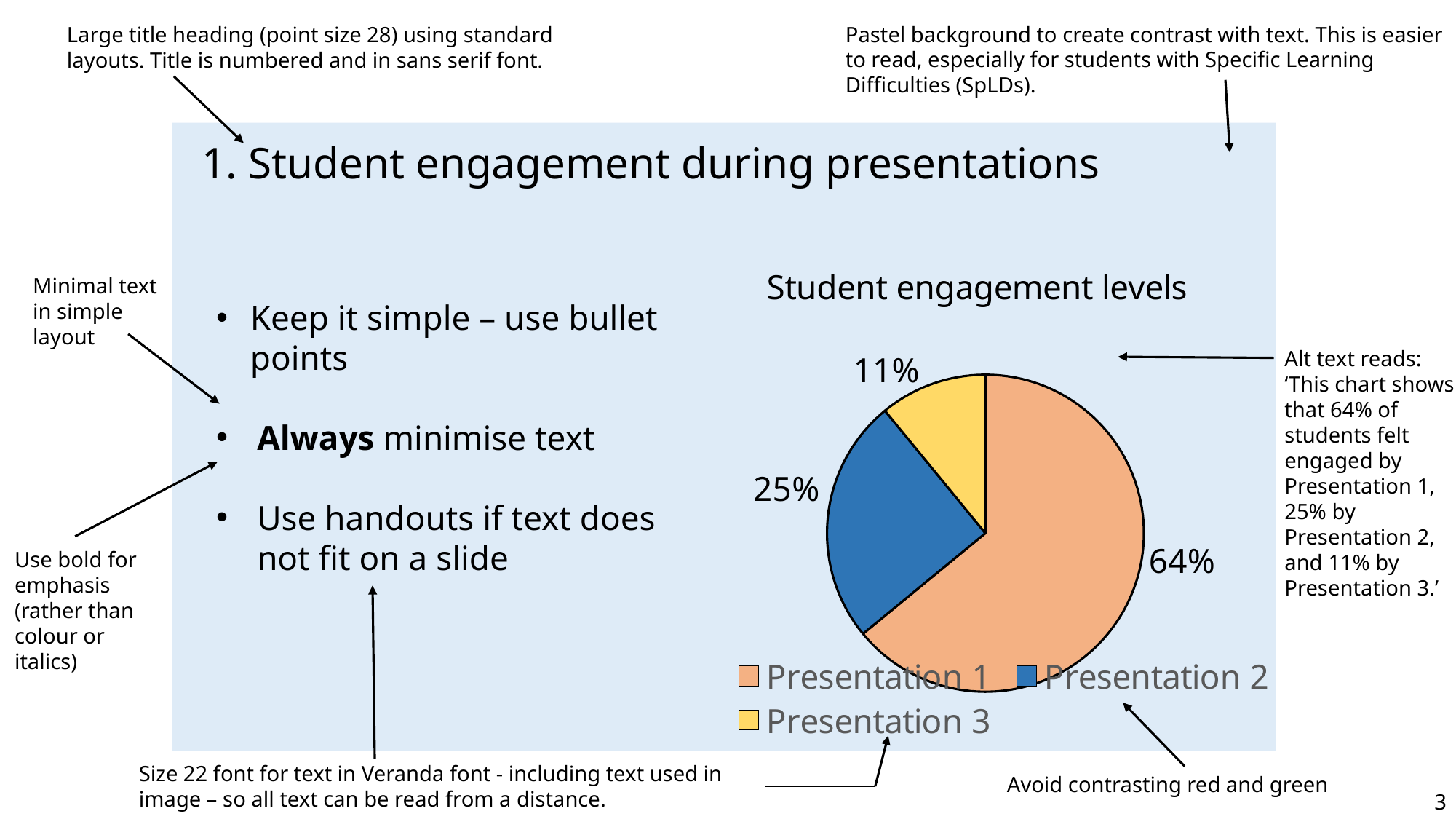
Which is larger, the share for Presentation 2 or Presentation 3? Presentation 2 What is the title of the chart? Student engagement levels Which presentation has the smallest share of the pie? Presentation 3 What is the difference in percentage points between Presentation 2 and Presentation 3? 14 What percentage of the pie is Presentation 3? 11% What colour is the slice for Presentation 2? blue What percentage of the pie is Presentation 1? 64% Which presentation has the largest share of the pie? Presentation 1 What is the difference in percentage points between Presentation 1 and Presentation 2? 39 What percentage of the pie is Presentation 2? 25% How many slices does the pie chart have? 3 What type of chart is shown on the slide? pie chart